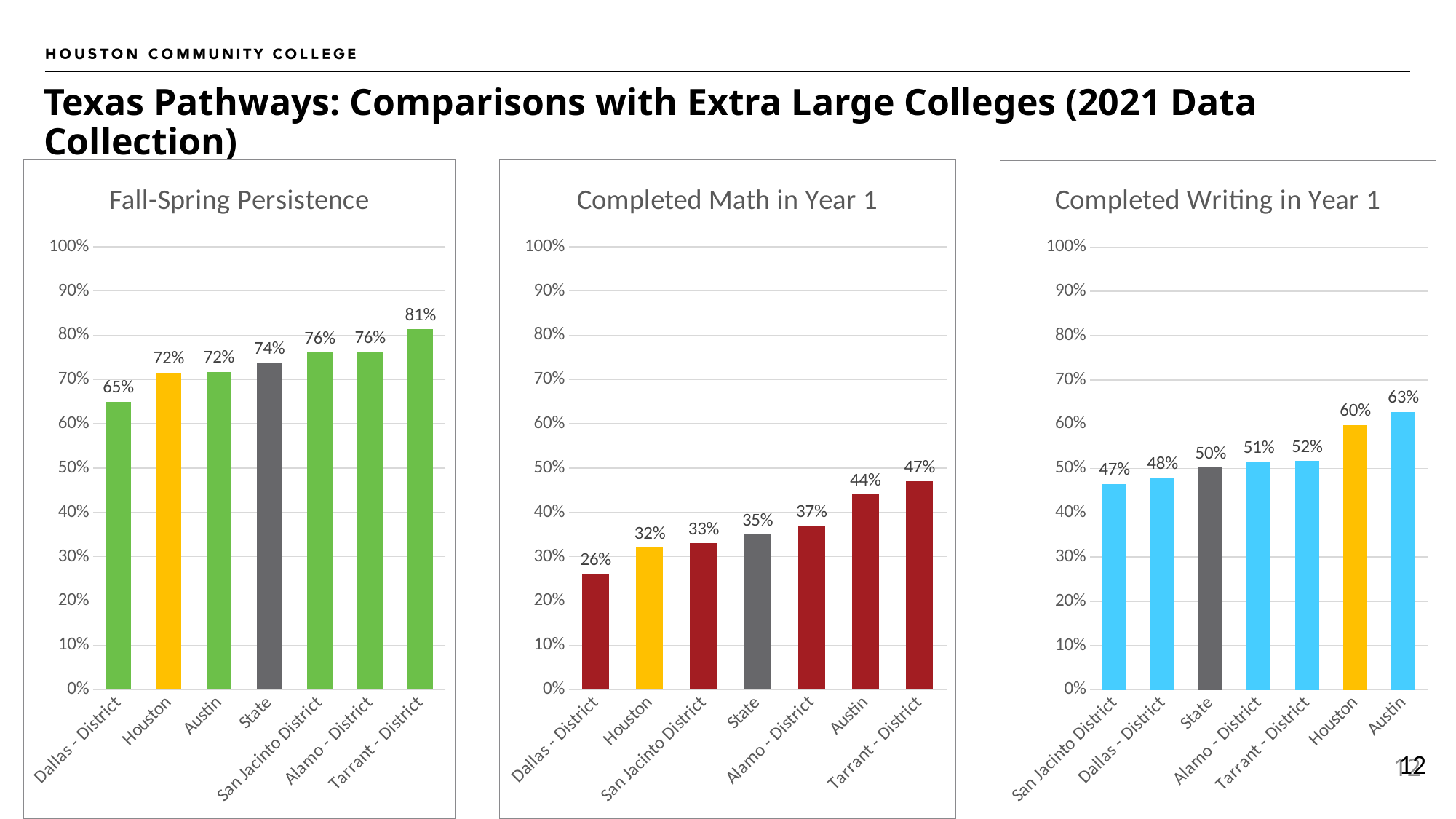
In the Fall-Spring Persistence chart, what is the value for Houston? 72% In the Completed Writing in Year 1 chart, which category has the highest value? Austin In the Fall-Spring Persistence chart, which category has the highest value? Tarrant - District In the Fall-Spring Persistence chart, which category has the lowest value? Dallas - District In the Completed Math in Year 1 chart, which is larger, Houston or Austin? Austin In the Completed Math in Year 1 chart, what is the value for State? 35% In the Completed Writing in Year 1 chart, what is the difference between Austin and San Jacinto District? 16% In the Fall-Spring Persistence chart, what is the difference between Tarrant - District and Dallas - District? 16% In the Completed Math in Year 1 chart, which category has the lowest value? Dallas - District What kind of chart is the Completed Writing in Year 1 chart? Bar chart In the Completed Writing in Year 1 chart, what is the value for Houston? 60% In the Completed Math in Year 1 chart, how many categories are shown? 7